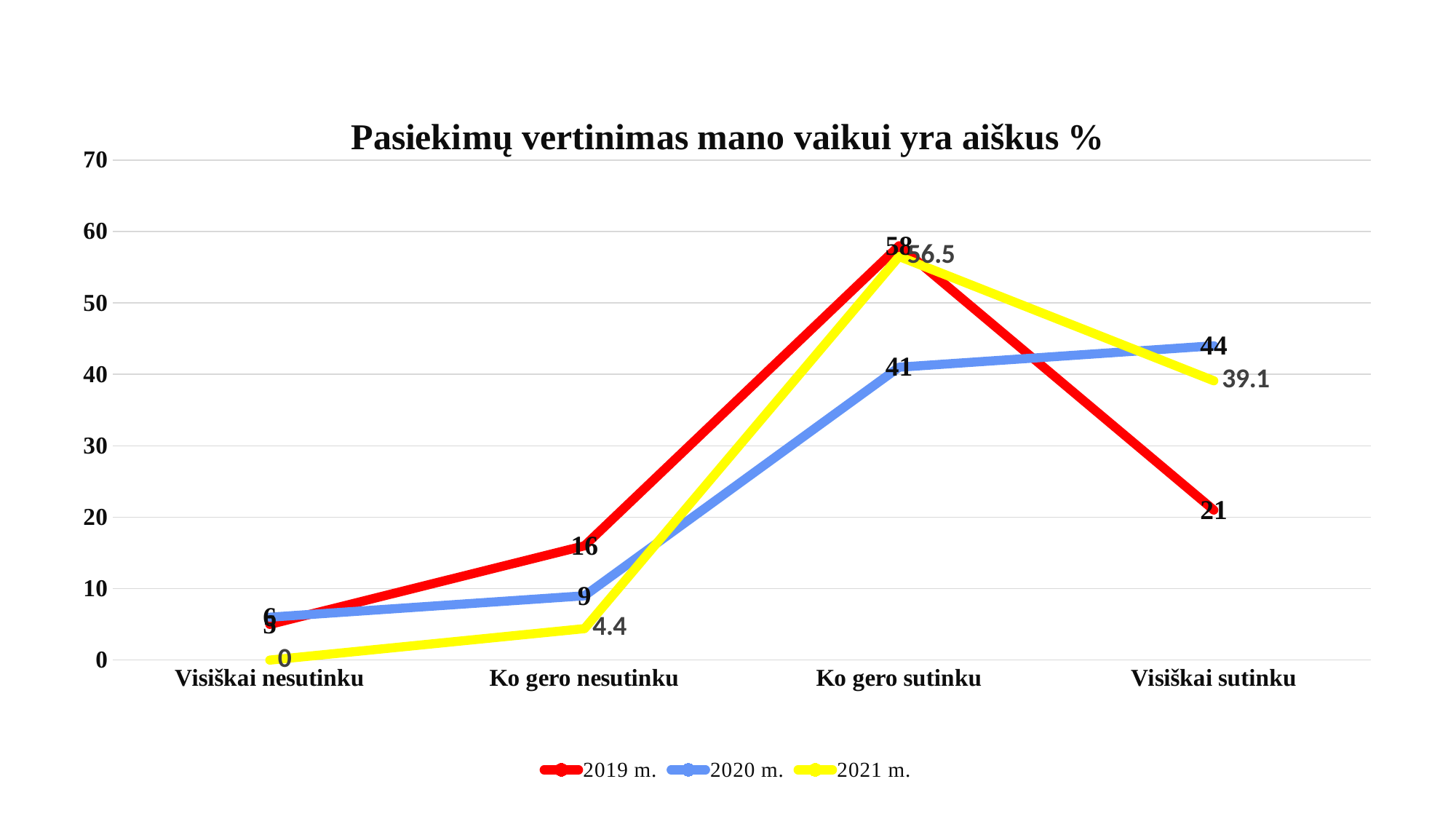
What is the value for 2021 m. at Visiškai nesutinku? 0 Which category has the lowest value for the 2020 m. series? Visiškai nesutinku What kind of chart is shown on the slide? line chart Which category has the highest value for the 2019 m. series? Ko gero sutinku What is the difference between the 2019 m. and 2020 m. values at Ko gero sutinku? 17 What is the value for 2020 m. at Visiškai sutinku? 44 How many series does the legend list? 3 What is the title of the chart? Pasiekimų vertinimas mano vaikui yra aiškus % At Visiškai sutinku, which series has the larger value, 2019 m. or 2021 m.? 2021 m. What is the value for 2019 m. at Ko gero nesutinku? 16 What is the value for 2021 m. at Ko gero sutinku? 56.5 How many categories are shown on the x axis? 4